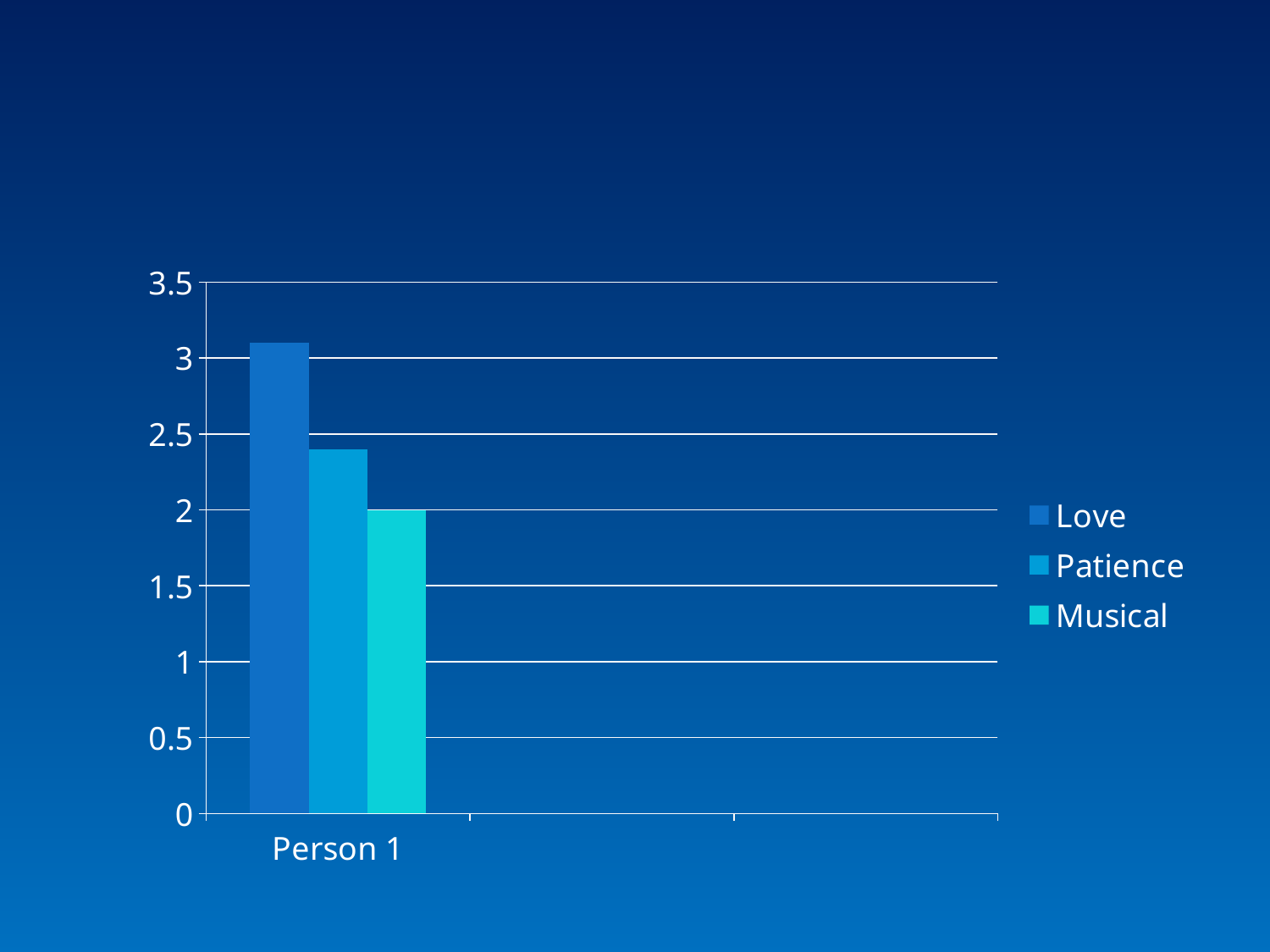
How many categories are shown on the x axis? 1 Is the value for Patience for Person 1 greater or less than 2.5? less Which is larger for Person 1, Patience or Musical? Patience What is the value for Musical for Person 1? 2 Which series has the lowest value for Person 1? Musical Is the value for Love for Person 1 greater or less than 3? greater What is the label of the category on the x axis? Person 1 What are the three entries in the legend? Love, Patience, Musical Which is larger for Person 1, Love or Patience? Love Which series has the highest value for Person 1? Love What kind of chart is shown on the slide? bar chart How many series does the legend list? 3